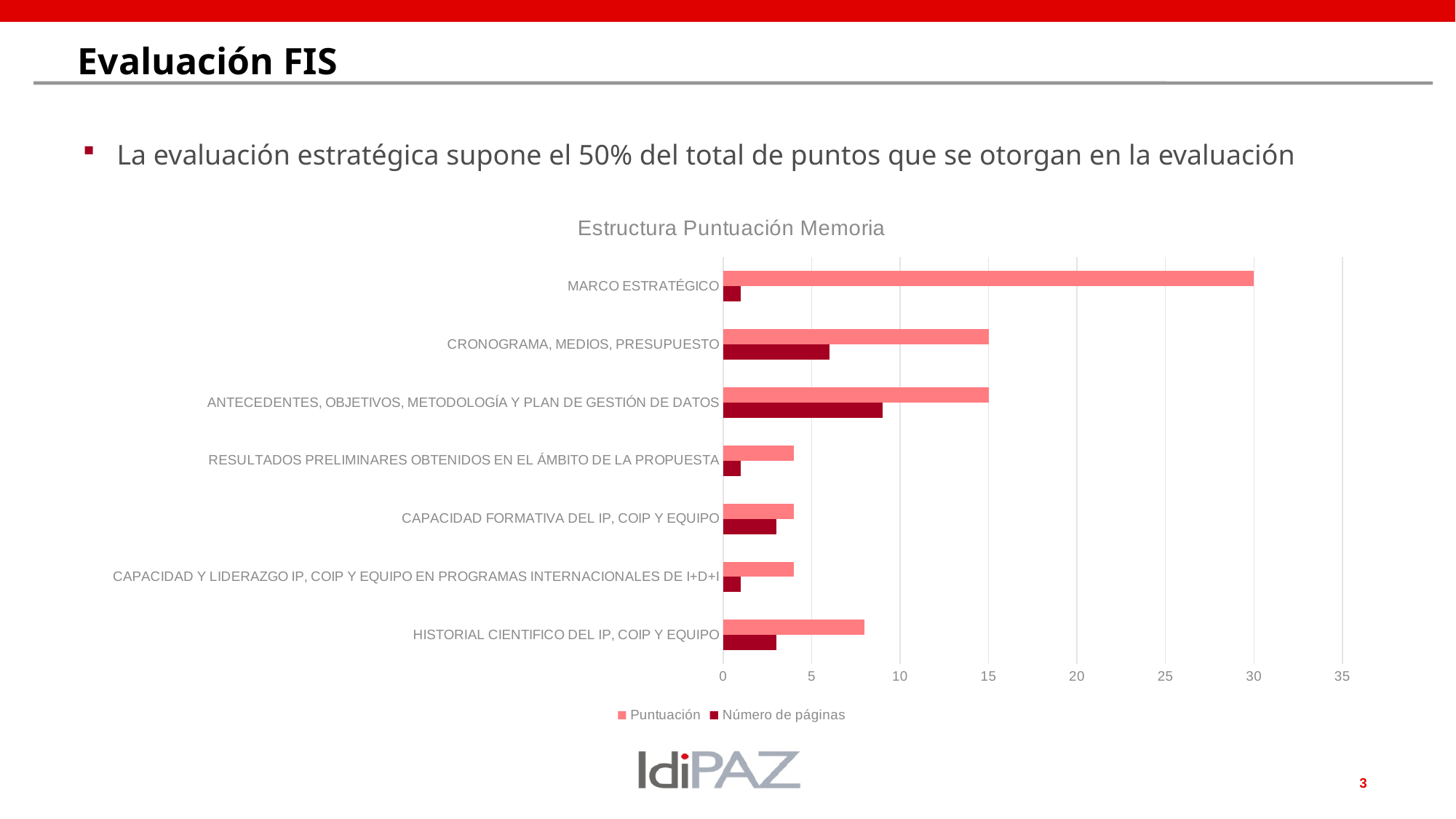
Is the Número de páginas value for ANTECEDENTES, OBJETIVOS, METODOLOGÍA Y PLAN DE GESTIÓN DE DATOS greater or less than 5? greater What is the title of the chart? Estructura Puntuación Memoria How many categories are shown on the chart? 7 What is the Puntuación value for CRONOGRAMA, MEDIOS, PRESUPUESTO? 15 Is the Número de páginas value for MARCO ESTRATÉGICO greater or less than 5? less How many series does the chart legend list? 2 Which category has the highest Puntuación? MARCO ESTRATÉGICO What kind of chart is shown on the slide? bar chart Which has a larger Número de páginas: ANTECEDENTES, OBJETIVOS, METODOLOGÍA Y PLAN DE GESTIÓN DE DATOS or CRONOGRAMA, MEDIOS, PRESUPUESTO? ANTECEDENTES, OBJETIVOS, METODOLOGÍA Y PLAN DE GESTIÓN DE DATOS Is the Puntuación value for HISTORIAL CIENTIFICO DEL IP, COIP Y EQUIPO greater or less than 10? less What is the difference between the Puntuación for MARCO ESTRATÉGICO and the Puntuación for CRONOGRAMA, MEDIOS, PRESUPUESTO? 15 What is the Puntuación value for MARCO ESTRATÉGICO? 30